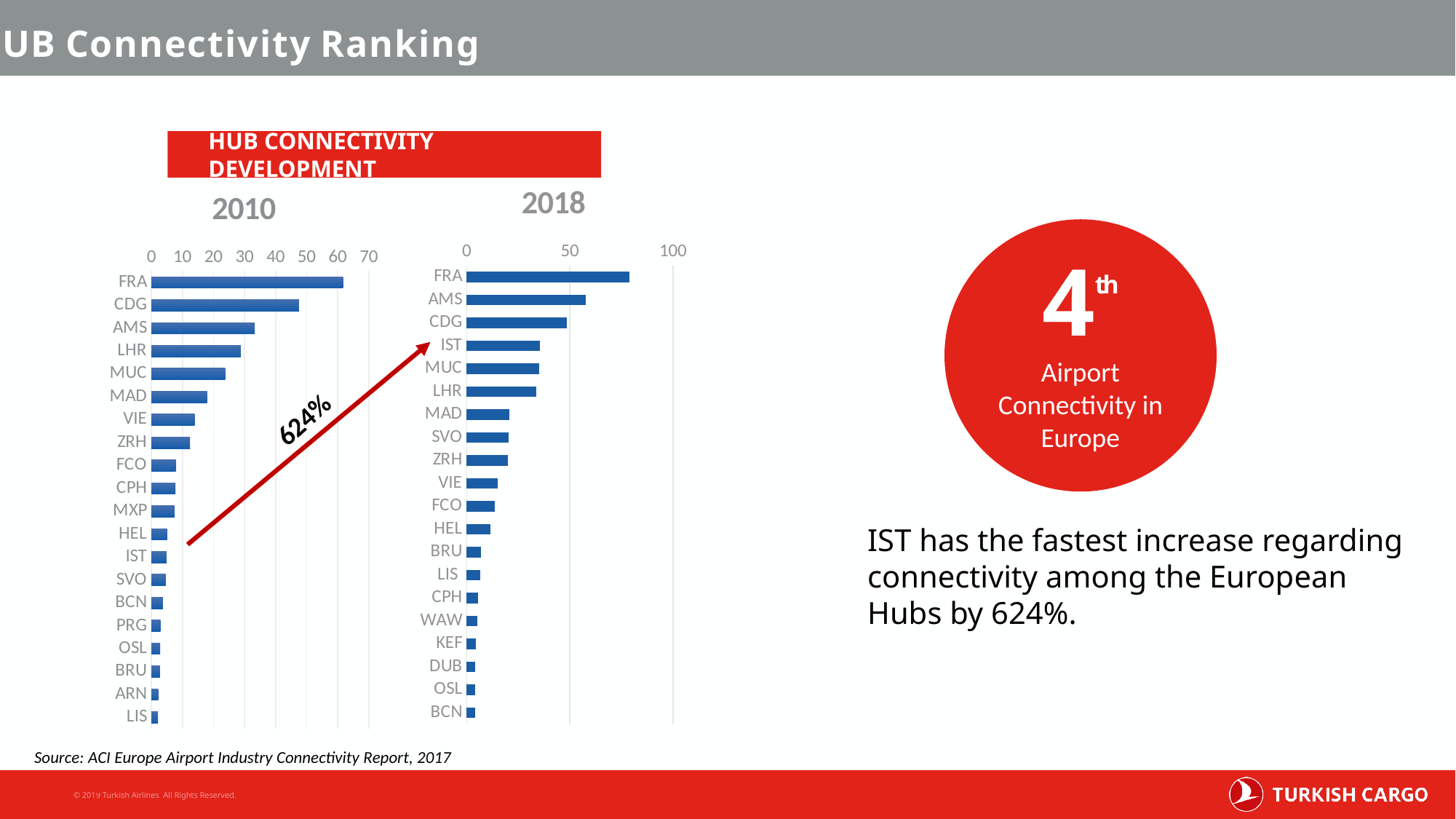
What kind of chart is the 2010 chart? bar chart In the 2018 chart, which airport has the highest connectivity value? FRA In the 2018 chart, which is larger, the value for AMS or the value for CDG? AMS In the 2010 chart, is the value for FRA greater or less than 50? greater In the 2010 chart, which airport has the highest connectivity value? FRA How many airports are listed in the 2010 chart? 20 How many airports are listed in the 2018 chart? 20 In the 2018 chart, is the value for AMS greater or less than 50? greater What percentage increase is written next to the arrow between the 2010 and 2018 charts? 624% In the 2010 chart, is the value for IST greater or less than 10? less In the 2010 chart, which airport has the lowest connectivity value? LIS